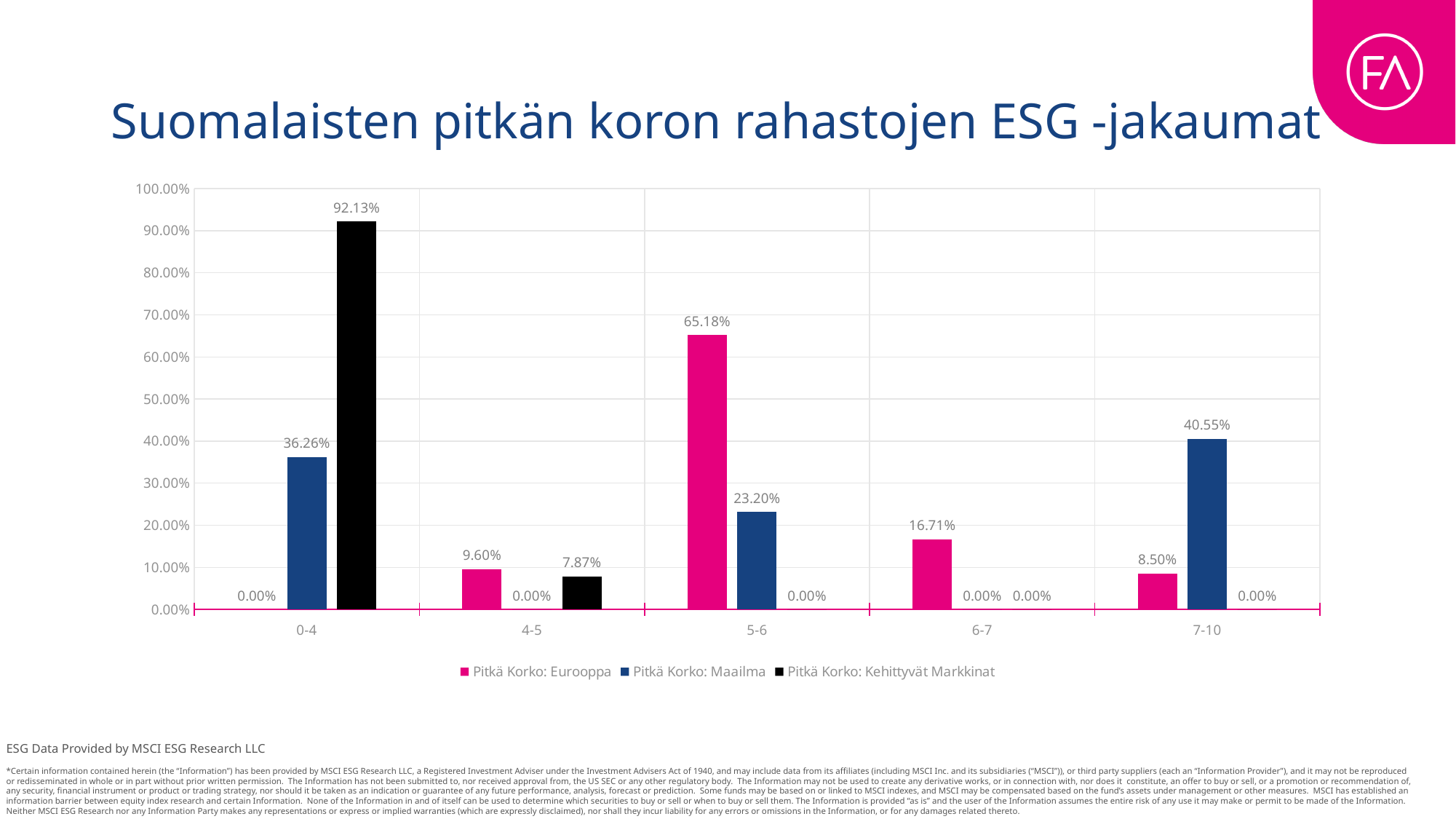
What is the value for Pitkä Korko: Kehittyvät Markkinat in the 0-4 category? 92.13% What is the value for Pitkä Korko: Maailma in the 7-10 category? 40.55% How many series does the legend list? 3 How many categories are shown on the x axis? 5 What is the title of the chart? Suomalaisten pitkän koron rahastojen ESG -jakaumat In which category does Pitkä Korko: Maailma have its highest value? 7-10 What is the value for Pitkä Korko: Eurooppa in the 5-6 category? 65.18% In which category does Pitkä Korko: Eurooppa have its lowest value? 0-4 What kind of chart is shown on the slide? Bar chart What is the difference between Pitkä Korko: Eurooppa and Pitkä Korko: Maailma in the 5-6 category? 41.98% In the 4-5 category, which is larger: Pitkä Korko: Eurooppa or Pitkä Korko: Kehittyvät Markkinat? Pitkä Korko: Eurooppa What is the value for Pitkä Korko: Eurooppa in the 6-7 category? 16.71%